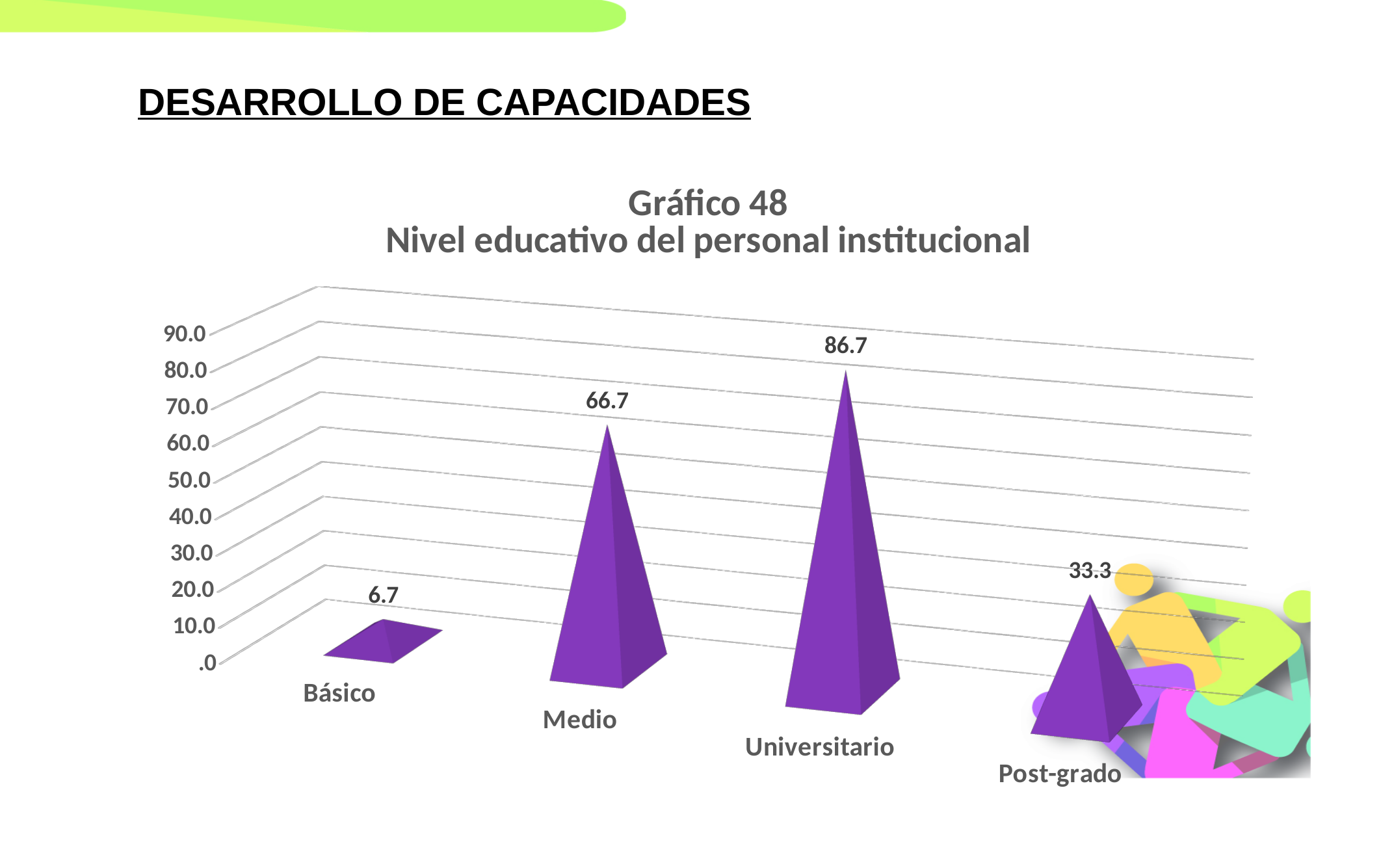
What is the difference between the values for Medio and Post-grado? 33.4 Which is larger, the value for Medio or the value for Post-grado? Medio What is the value for Básico? 6.7 What is the value for Post-grado? 33.3 What is the difference between the values for Universitario and Medio? 20.0 What is the value for Medio? 66.7 Which category has the lowest value? Básico What is the title of the chart? Gráfico 48 Nivel educativo del personal institucional What kind of chart is this? Bar chart Which category has the highest value? Universitario What is the value for Universitario? 86.7 How many categories are shown on the x axis? 4